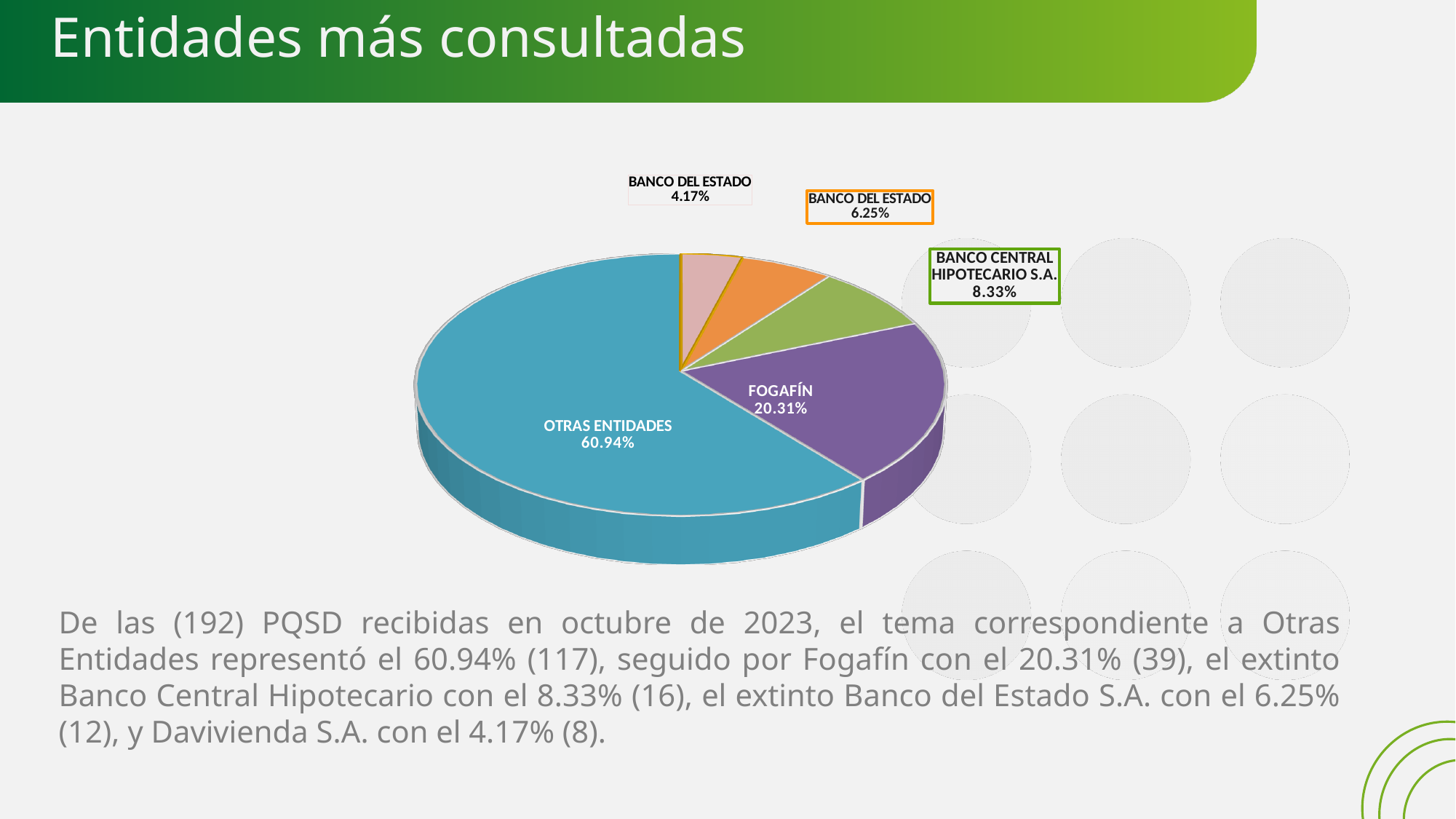
What is the difference in percentage points between OTRAS ENTIDADES and FOGAFÍN? 40.63% What percentage does the BANCO CENTRAL HIPOTECARIO S.A. slice represent? 8.33% What kind of chart is shown on the slide? pie chart Which slice is larger, FOGAFÍN or BANCO CENTRAL HIPOTECARIO S.A.? FOGAFÍN Is the share for OTRAS ENTIDADES greater or less than 50%? greater Which category has the largest slice of the pie? OTRAS ENTIDADES What percentage does the OTRAS ENTIDADES slice represent? 60.94% What percentage does the FOGAFÍN slice represent? 20.31% What is the difference in percentage points between FOGAFÍN and BANCO CENTRAL HIPOTECARIO S.A.? 11.98% What is the percentage of the smallest slice in the pie? 4.17% How many slices does the pie chart have? 5 What is the title of the slide containing the pie chart? Entidades más consultadas